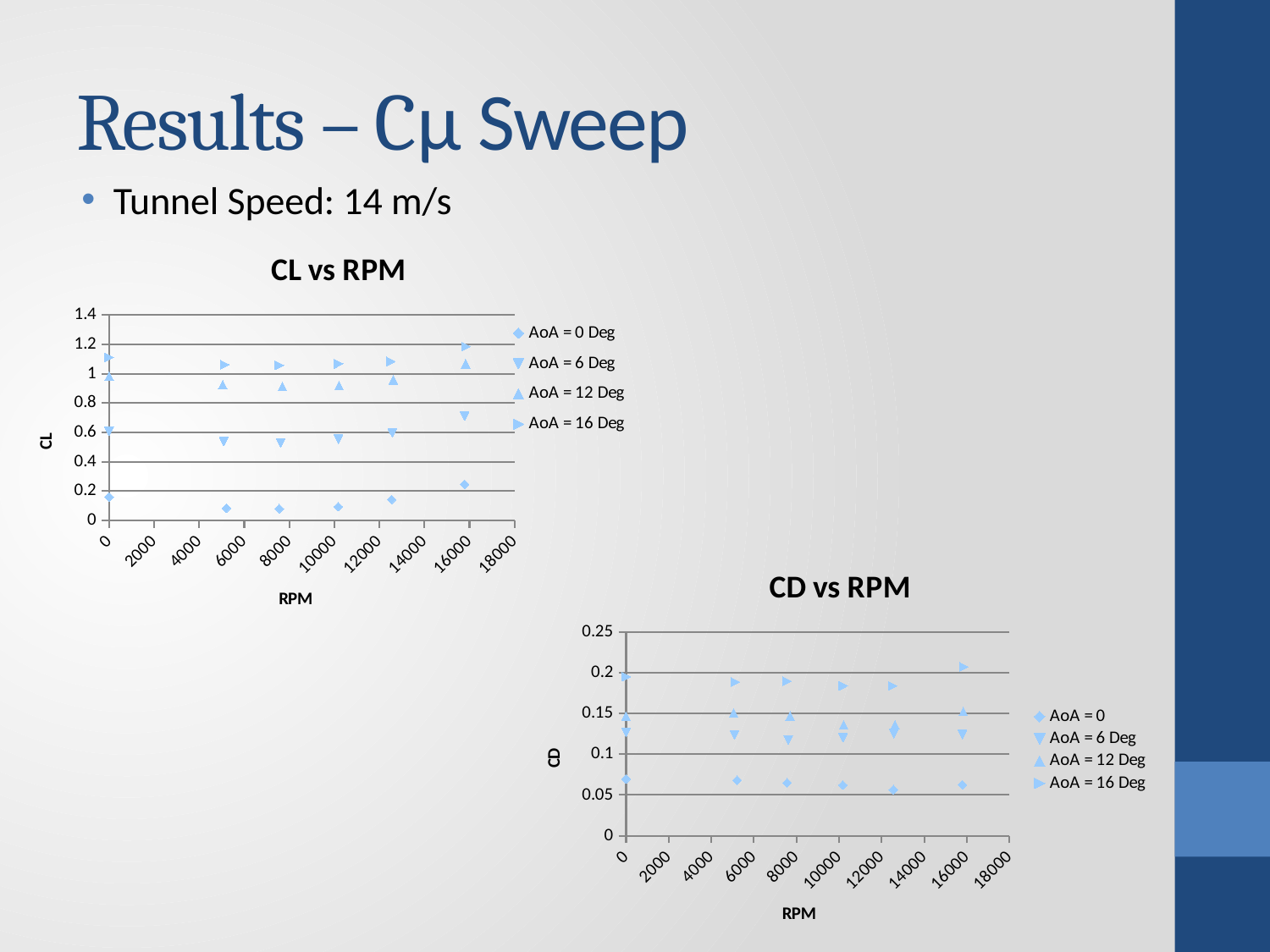
In the "CD vs RPM" chart, which series has higher CD values, AoA = 16 Deg or AoA = 0? AoA = 16 Deg In the "CL vs RPM" chart, which series has the lowest CL values? AoA = 0 Deg In the "CL vs RPM" chart, is the CL value for AoA = 16 Deg at 0 RPM greater or less than 1? greater What is the x-axis label of the "CL vs RPM" chart? RPM In the "CD vs RPM" chart, which series has the lowest CD values? AoA = 0 In the "CL vs RPM" chart, which series has the highest CL values? AoA = 16 Deg In the "CL vs RPM" chart, is the CL value for AoA = 0 Deg at 0 RPM greater or less than 0.2? less How many series does the legend of the "CD vs RPM" chart list? 4 In the "CD vs RPM" chart, is the CD value for AoA = 0 at 0 RPM greater or less than 0.1? less What kind of chart is the "CL vs RPM" chart? scatter chart What is the title of the chart on the lower right of the slide? CD vs RPM